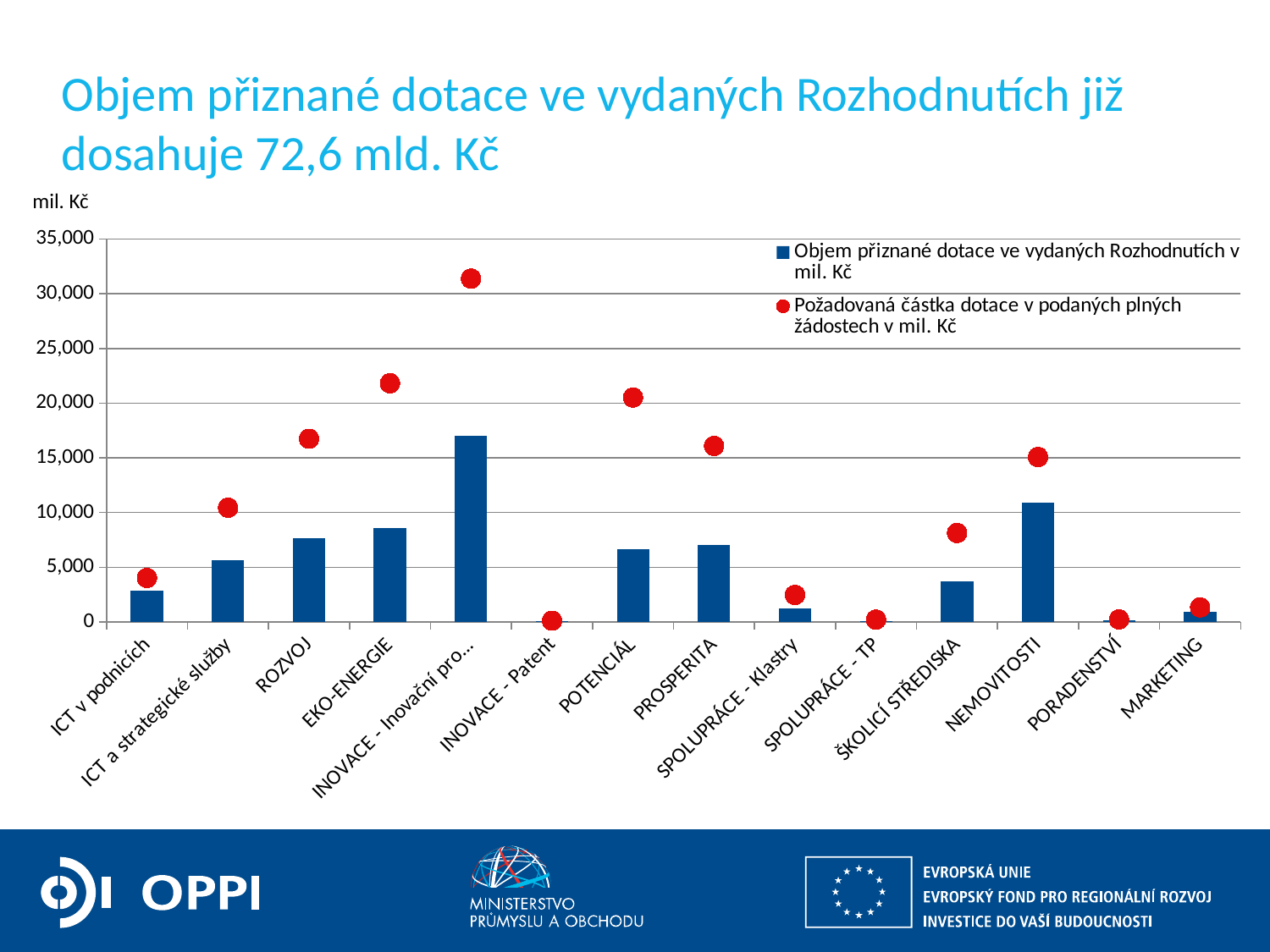
How many series does the legend list? 2 Is the 'Objem přiznané dotace ve vydaných Rozhodnutích' value for NEMOVITOSTI greater or less than 10,000? greater What kind of chart is shown on the slide? A bar chart combined with a dot (marker) series Which has the larger 'Požadovaná částka dotace v podaných plných žádostech' value, POTENCIÁL or ICT a strategické služby? POTENCIÁL What unit is shown above the vertical axis of the chart? mil. Kč Is the 'Požadovaná částka dotace v podaných plných žádostech' value for EKO-ENERGIE greater or less than 20,000? greater Is the 'Objem přiznané dotace ve vydaných Rozhodnutích' value for ŠKOLICÍ STŘEDISKA greater or less than 5,000? less Which category has the highest value for 'Objem přiznané dotace ve vydaných Rozhodnutích v mil. Kč'? INOVACE - Inovační pro... Which has the larger 'Objem přiznané dotace ve vydaných Rozhodnutích' value, NEMOVITOSTI or EKO-ENERGIE? NEMOVITOSTI How many programme categories are shown on the x axis? 14 Which category has the highest value for 'Požadovaná částka dotace v podaných plných žádostech v mil. Kč'? INOVACE - Inovační pro...